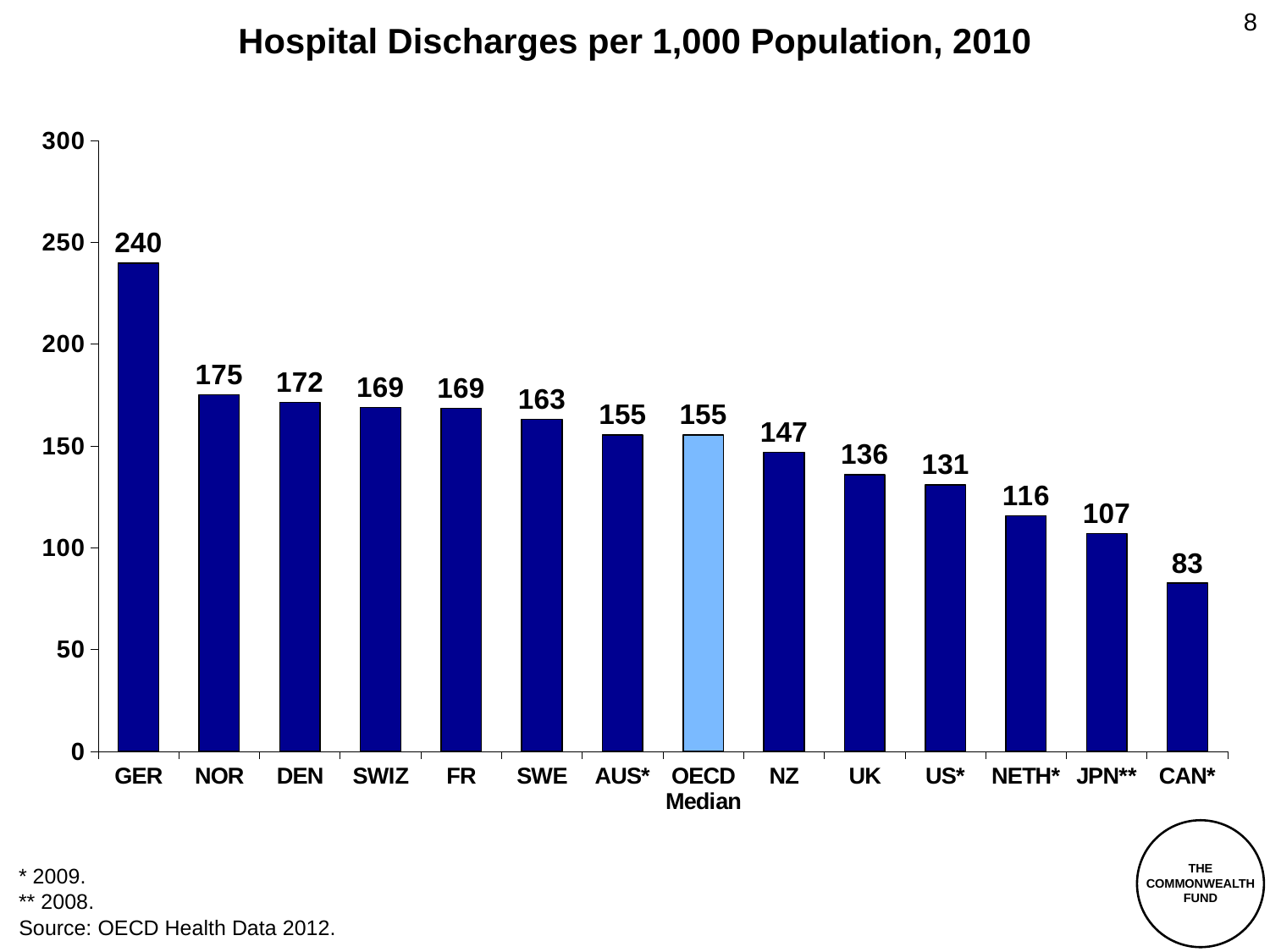
Is the value for JPN** greater or less than 150? less What is the value for US*? 131 What is the difference between the values for UK and CAN*? 53 Which country has the highest hospital discharges per 1,000 population? GER How many bars are shown in the chart? 14 Which country has the lowest hospital discharges per 1,000 population? CAN* What is the value for GER? 240 What kind of chart is shown on the slide? bar chart What is the value for the OECD Median? 155 Which is larger, the value for NZ or the value for NETH*? NZ What is the title of the chart? Hospital Discharges per 1,000 Population, 2010 What is the difference between the values for GER and NOR? 65